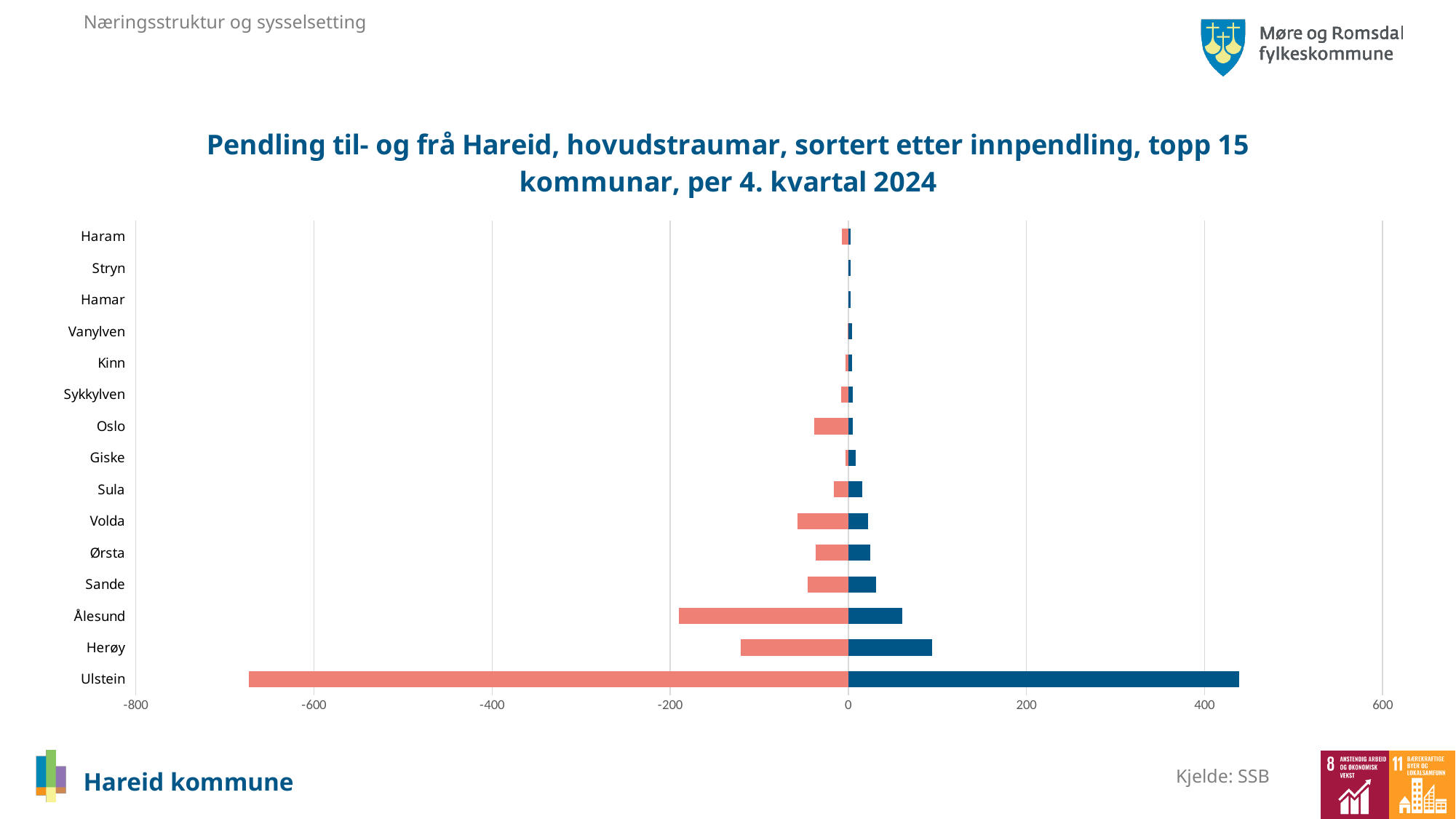
Which municipality has the longest blue bar (highest innpendling) in the chart? Ulstein Do the blue bars get longer or shorter moving down the chart from Haram to Ulstein? longer Which has the longer blue bar, Herøy or Ålesund? Herøy What kind of chart is shown on the slide? bar chart Is the red bar value for Herøy greater or less than -200? greater Is the red bar value for Ulstein greater or less than -600? less Which has the longer red bar, Ålesund or Herøy? Ålesund Which municipality has the longest red bar (largest negative value) in the chart? Ulstein How many municipalities (categories) are listed on the vertical axis of the chart? 15 Is the blue bar value for Herøy greater or less than 200? less What is the title of the chart? Pendling til- og frå Hareid, hovudstraumar, sortert etter innpendling, topp 15 kommunar, per 4. kvartal 2024